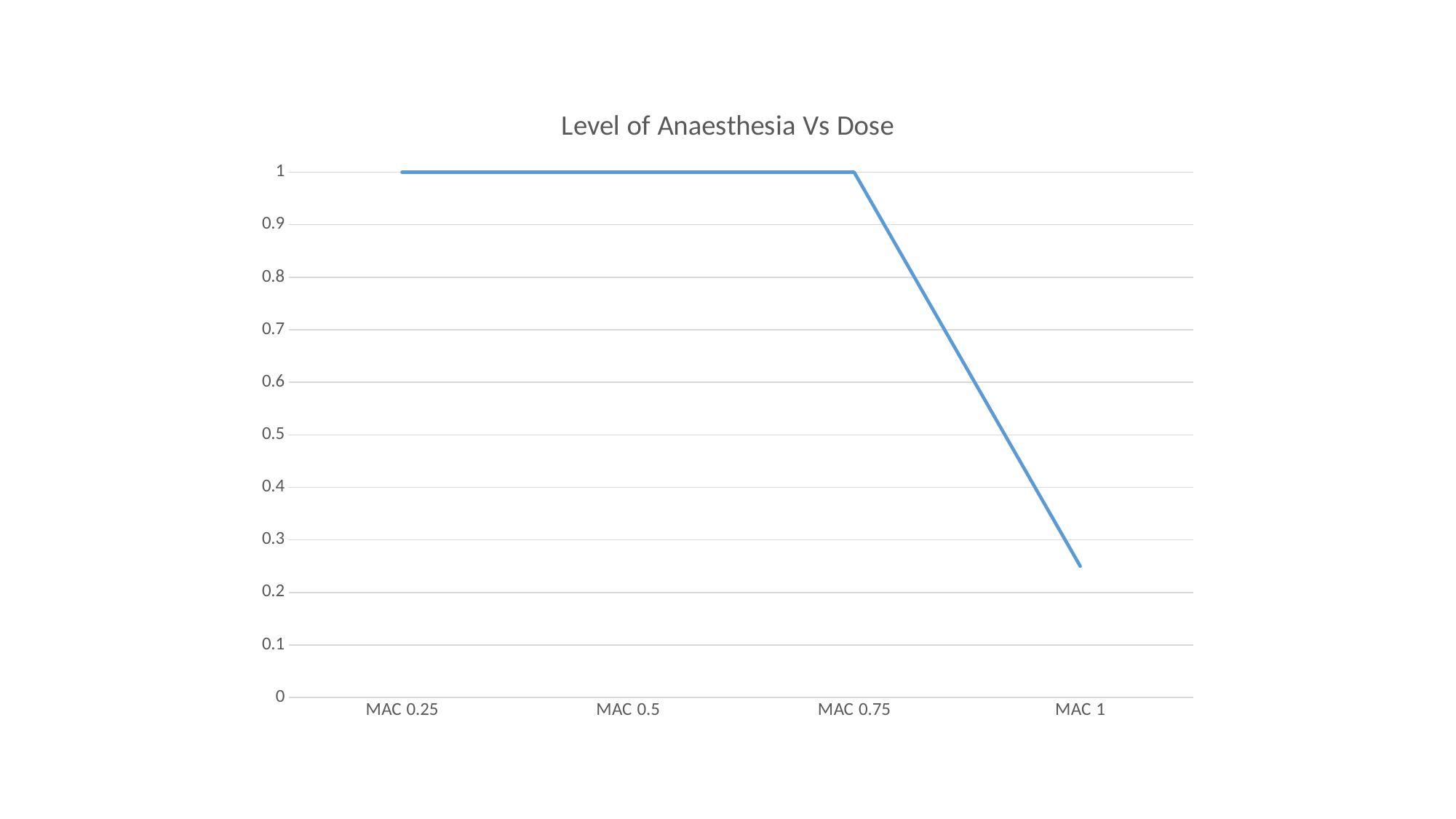
What is the value for MAC 0.75? 1 How many dose categories are shown on the x axis? 4 What is the value for MAC 0.5? 1 Which has the larger value, MAC 0.75 or MAC 1? MAC 0.75 What is the title of the chart? Level of Anaesthesia Vs Dose What is the highest value shown on the y axis? 1 Which dose category has the lowest value? MAC 1 Is the value for MAC 1 greater or less than 0.5? less What is the value for MAC 0.25? 1 Does the line rise or fall between MAC 0.75 and MAC 1? fall What kind of chart is shown on the slide? line chart Is the value for MAC 1 greater or less than 0.2? greater